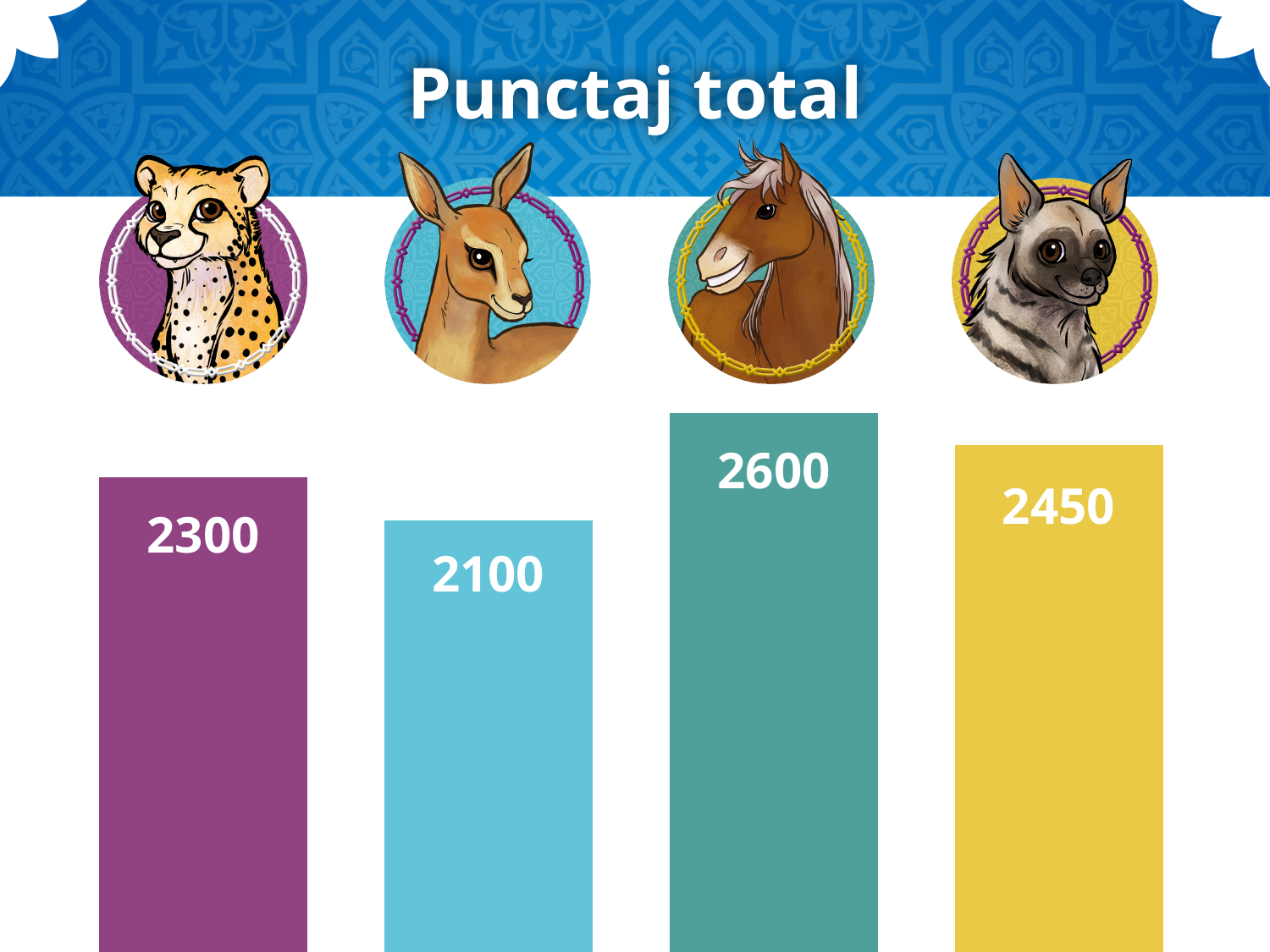
What is the difference between the highest and lowest values on the chart? 500 What kind of chart is shown on the slide? bar chart Which is larger, the value of the first bar or the fourth bar? the fourth bar (2450) What is the value of the fourth (yellow) bar, under the hyena? 2450 What is the difference between the fourth bar and the first bar? 150 Which bar has the lowest value? the second (light blue) bar, 2100 What is the value of the third (teal) bar, under the horse? 2600 What is the title of the chart? Punctaj total What is the value of the second (light blue) bar? 2100 How many bars does the chart have? 4 Which bar has the highest value? the third (teal) bar, 2600 What is the value of the first (purple) bar, under the cheetah? 2300